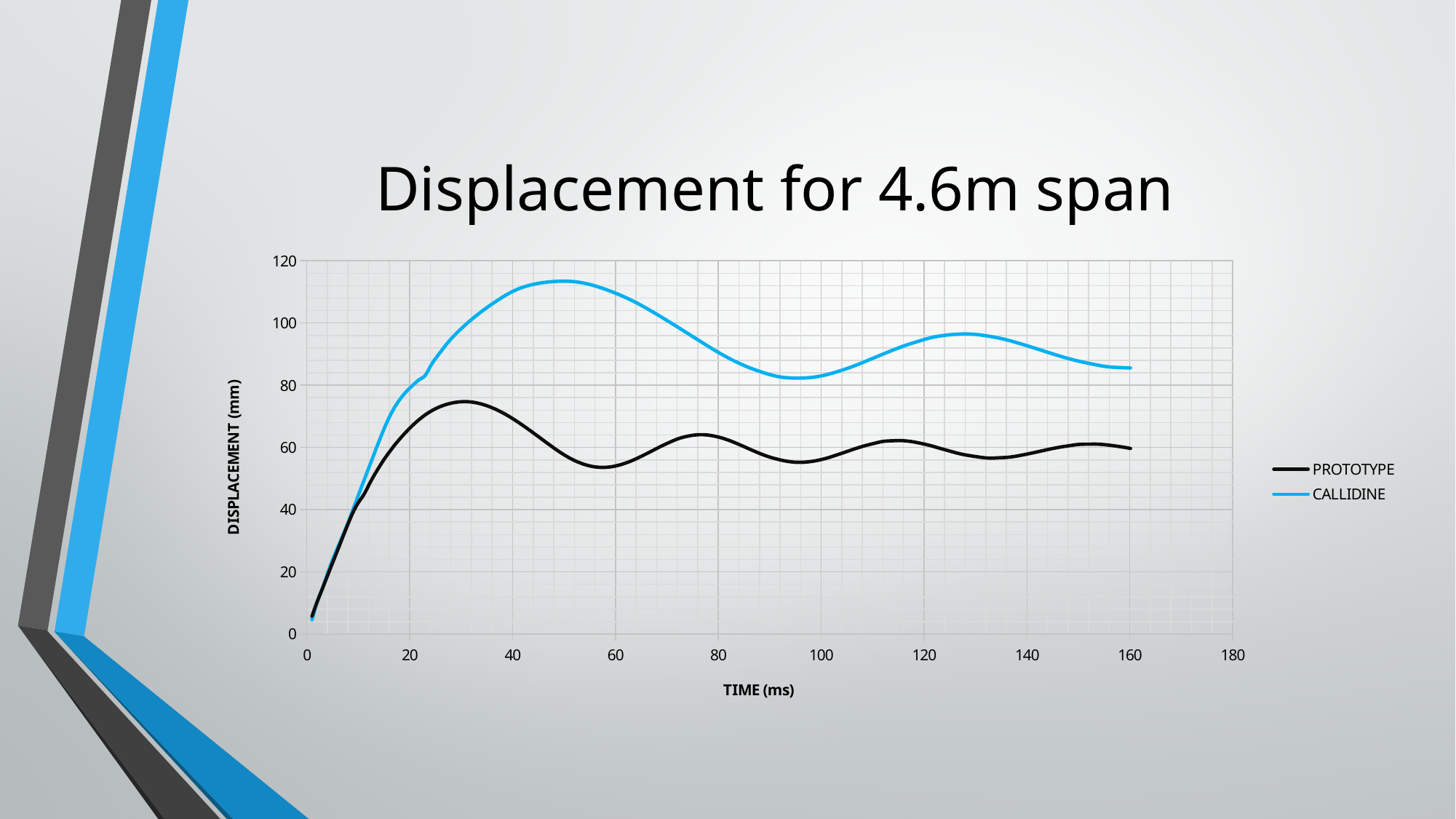
What kind of chart is shown on the slide? Line chart What is the label of the x axis? TIME (ms) At 100 ms, which series has the larger displacement, PROTOTYPE or CALLIDINE? CALLIDINE What is the title of the chart? Displacement for 4.6m span Is the PROTOTYPE value at 100 ms greater or less than 60? less Is the PROTOTYPE value at 40 ms greater or less than 60? greater How many series does the legend list? 2 Is the peak value of the PROTOTYPE series greater or less than 80? less Between 50 ms and 60 ms, does the CALLIDINE line rise or fall? fall Which series reaches the higher peak displacement, PROTOTYPE or CALLIDINE? CALLIDINE